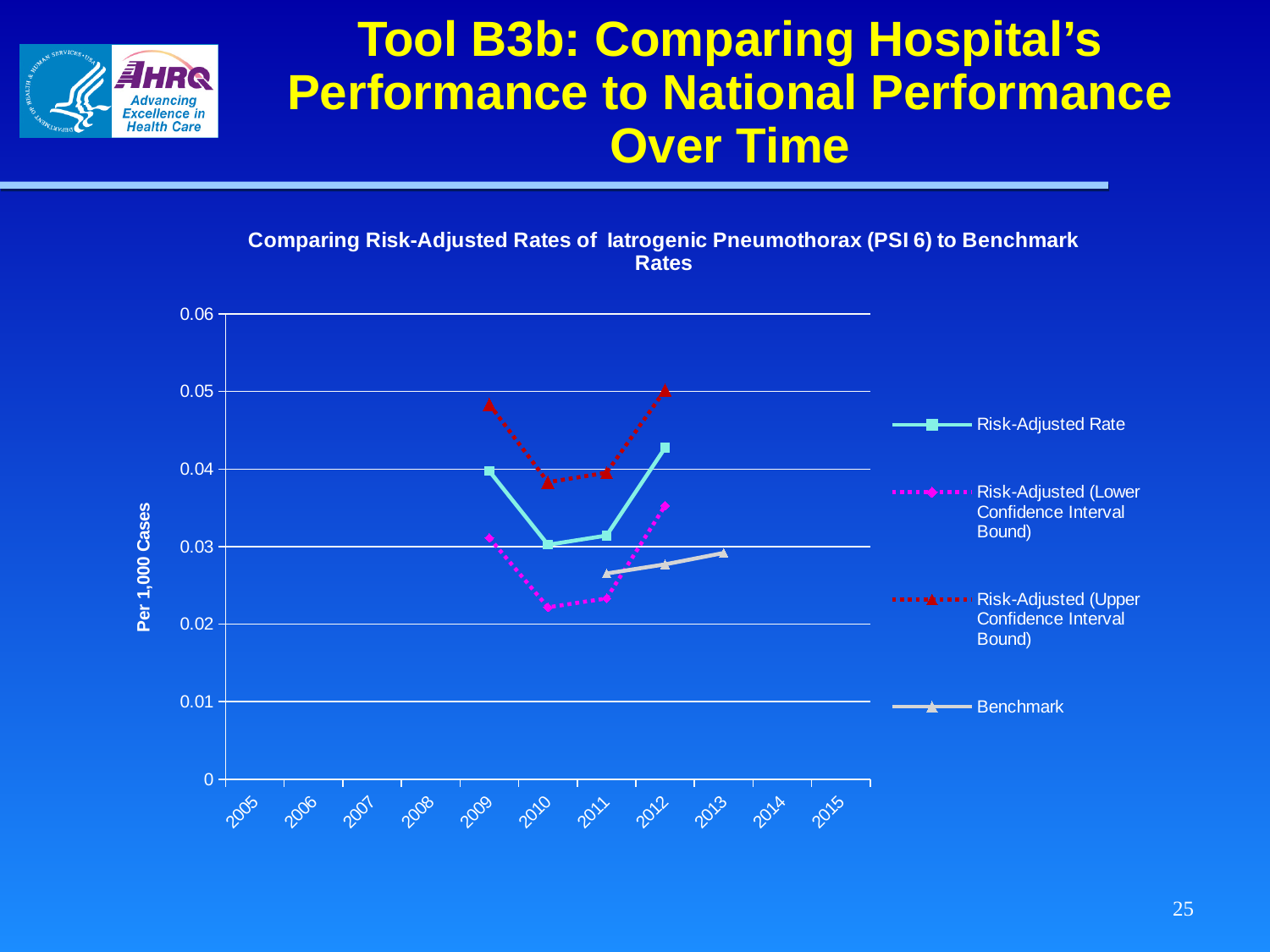
In which year is the Risk-Adjusted Rate highest? 2012 Is the Risk-Adjusted (Upper Confidence Interval Bound) value for 2009 greater or less than 0.04? greater How many series does the legend list? 4 What is the label on the y axis? Per 1,000 Cases Is the Risk-Adjusted Rate for 2012 greater or less than 0.04? greater In 2012, which is larger: the Risk-Adjusted Rate or the Benchmark? Risk-Adjusted Rate How many years are labelled along the x axis? 11 Is the Risk-Adjusted (Lower Confidence Interval Bound) value for 2010 greater or less than 0.03? less Does the Benchmark series rise or fall from 2011 to 2013? Rise What kind of chart is shown on the slide? Line chart How many data points are plotted for the Benchmark series? 3